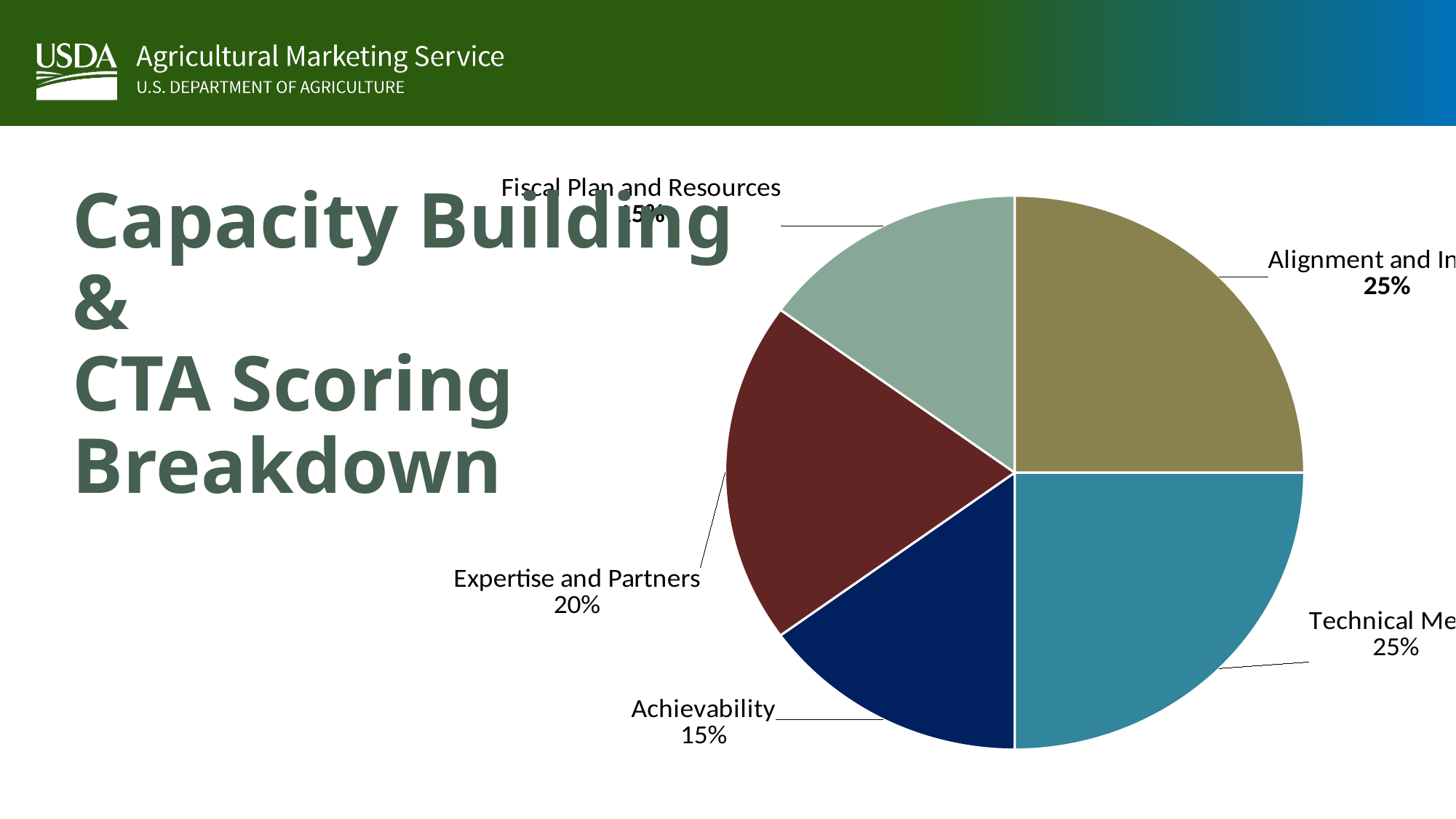
What is the difference between the Expertise and Partners share and the Achievability share? 5% What share of the pie does Expertise and Partners take? 20% How many slices does the pie chart have? 5 Which is larger, Expertise and Partners or Achievability? Expertise and Partners What kind of chart is shown on the slide? pie chart What do Expertise and Partners and Achievability add up to together? 35% What colour is the Achievability slice? dark navy blue What percentage is shown for Fiscal Plan and Resources? 15% What percentage is shown for Achievability? 15% What is the title of the slide? Capacity Building & CTA Scoring Breakdown What percentage is shown for Expertise and Partners? 20%